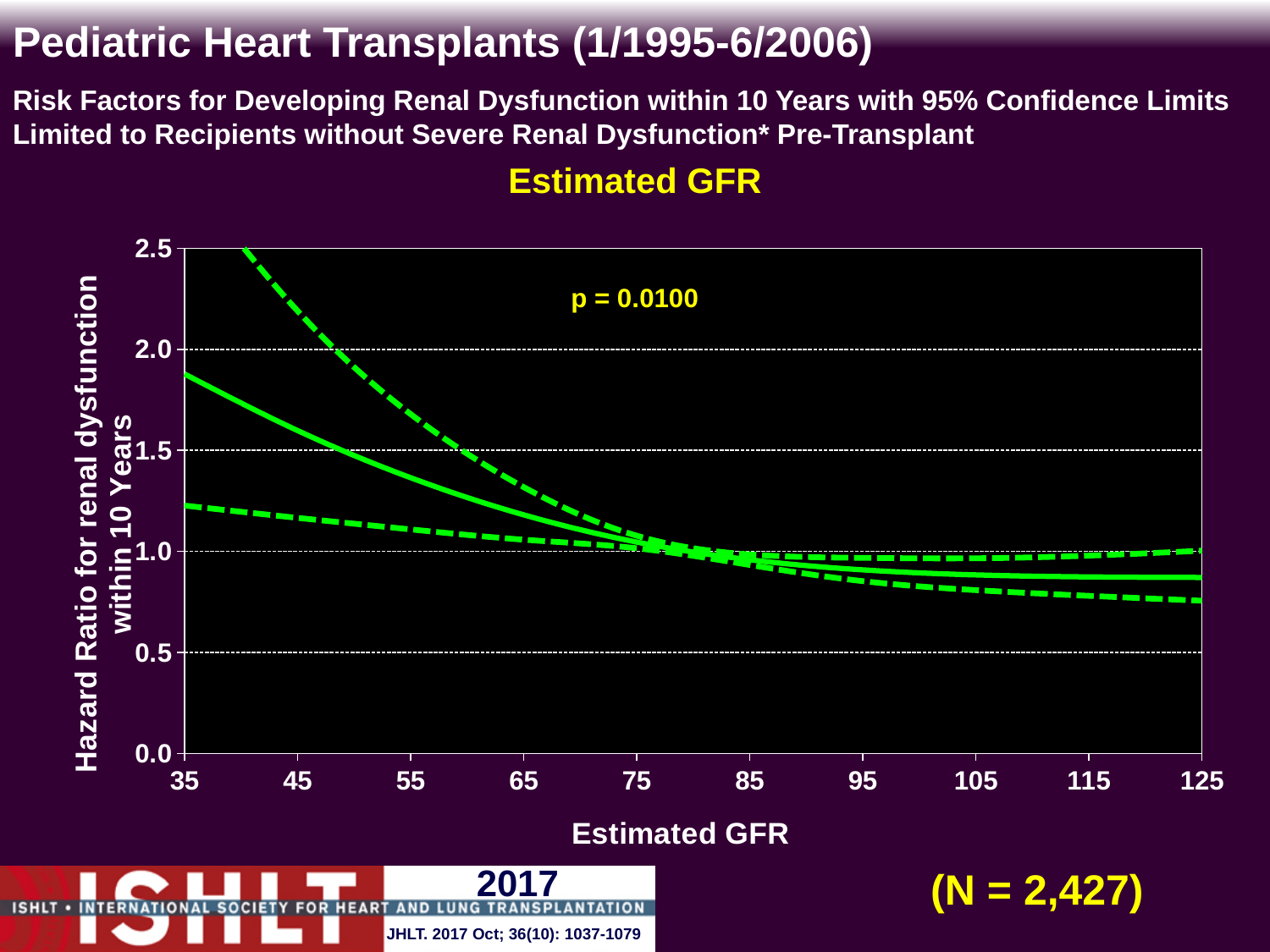
Is the solid hazard ratio line higher at an Estimated GFR of 35 or at an Estimated GFR of 125? 35 Is the hazard ratio on the solid line at an Estimated GFR of 125 greater or less than 1.0? less As Estimated GFR increases along the x axis, does the solid hazard ratio line rise or fall? fall What is the highest value shown on the y axis? 2.5 What kind of chart is shown on the slide? line chart How many lines are plotted on the chart? 3 What p-value is printed on the chart? p = 0.0100 Is the lower dashed confidence limit at an Estimated GFR of 35 greater or less than 1.0? greater Is the hazard ratio on the solid line at an Estimated GFR of 95 greater or less than 1.0? less